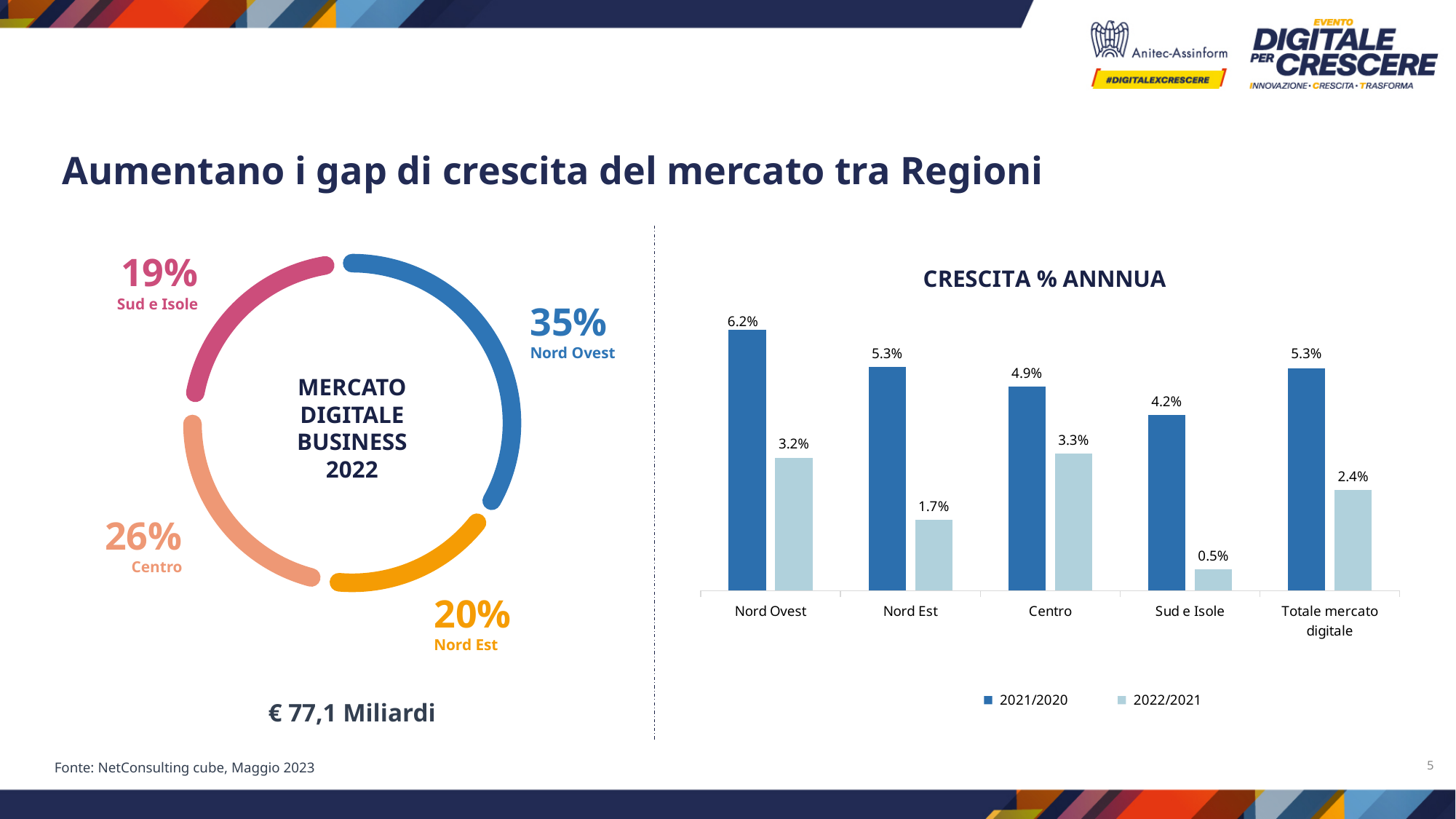
In the 'MERCATO DIGITALE BUSINESS 2022' donut chart on the left, which region has the smallest share? Sud e Isole In the 'CRESCITA % ANNNUA' bar chart, what is the 2021/2020 value for Nord Ovest? 6.2% In the 'CRESCITA % ANNNUA' bar chart, which category has the lowest 2022/2021 value? Sud e Isole In the 'CRESCITA % ANNNUA' bar chart, what is the 2022/2021 value for Totale mercato digitale? 2.4% How many categories are shown on the x axis of the 'CRESCITA % ANNNUA' chart? 5 In the 'CRESCITA % ANNNUA' bar chart, what is the 2022/2021 value for Sud e Isole? 0.5% In the 'CRESCITA % ANNNUA' bar chart, what is the difference between the 2021/2020 and 2022/2021 values for Nord Est? 3.6% In the 'CRESCITA % ANNNUA' bar chart, which category has the highest 2021/2020 value? Nord Ovest How many series does the legend of the 'CRESCITA % ANNNUA' bar chart list? 2 What kind of chart is the 'CRESCITA % ANNNUA' chart on the right of the slide? Bar chart In the 'CRESCITA % ANNNUA' bar chart, which is larger: the 2022/2021 value for Centro or for Nord Ovest? Centro In the 'MERCATO DIGITALE BUSINESS 2022' donut chart on the left, what share does Nord Ovest have? 35%